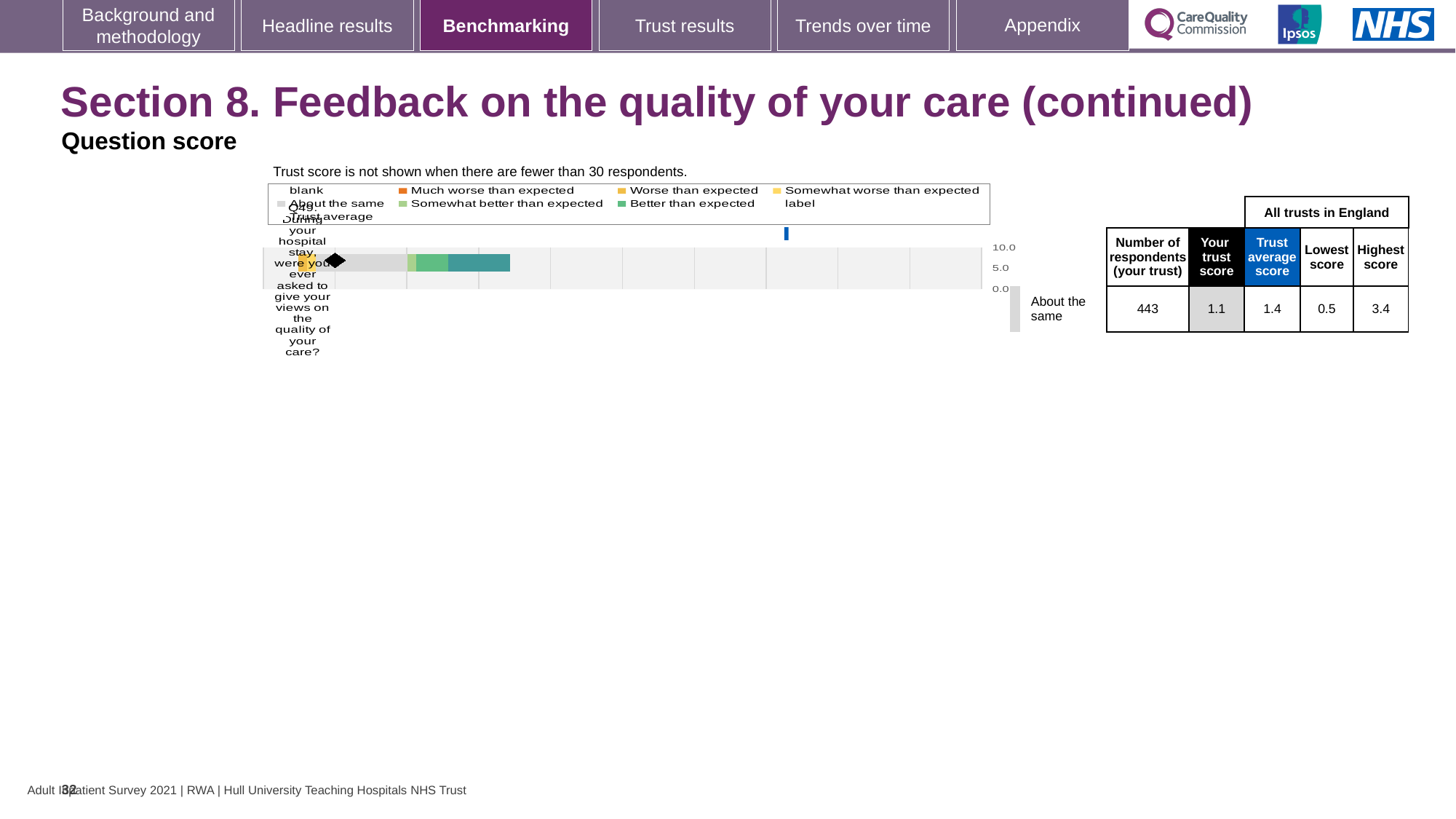
Which is larger for Q49: your trust score or the trust average score? Trust average score What benchmark category is shown next to the Q49 bar? About the same How many respondents from your trust answered Q49? 443 What is the highest score among all trusts in England for Q49? 3.4 What is the difference between the highest score and the lowest score for Q49 across all trusts in England? 2.9 Is your trust score for Q49 greater or less than 5.0? less What kind of chart is shown on the slide for Q49? bar chart What is the lowest score among all trusts in England for Q49? 0.5 What is the trust average score for Q49 across all trusts in England? 1.4 Which colour in the legend represents 'Much worse than expected'? Orange What is the trust score for Q49 (your trust score)? 1.1 What is the difference between the trust average score and your trust score for Q49? 0.3